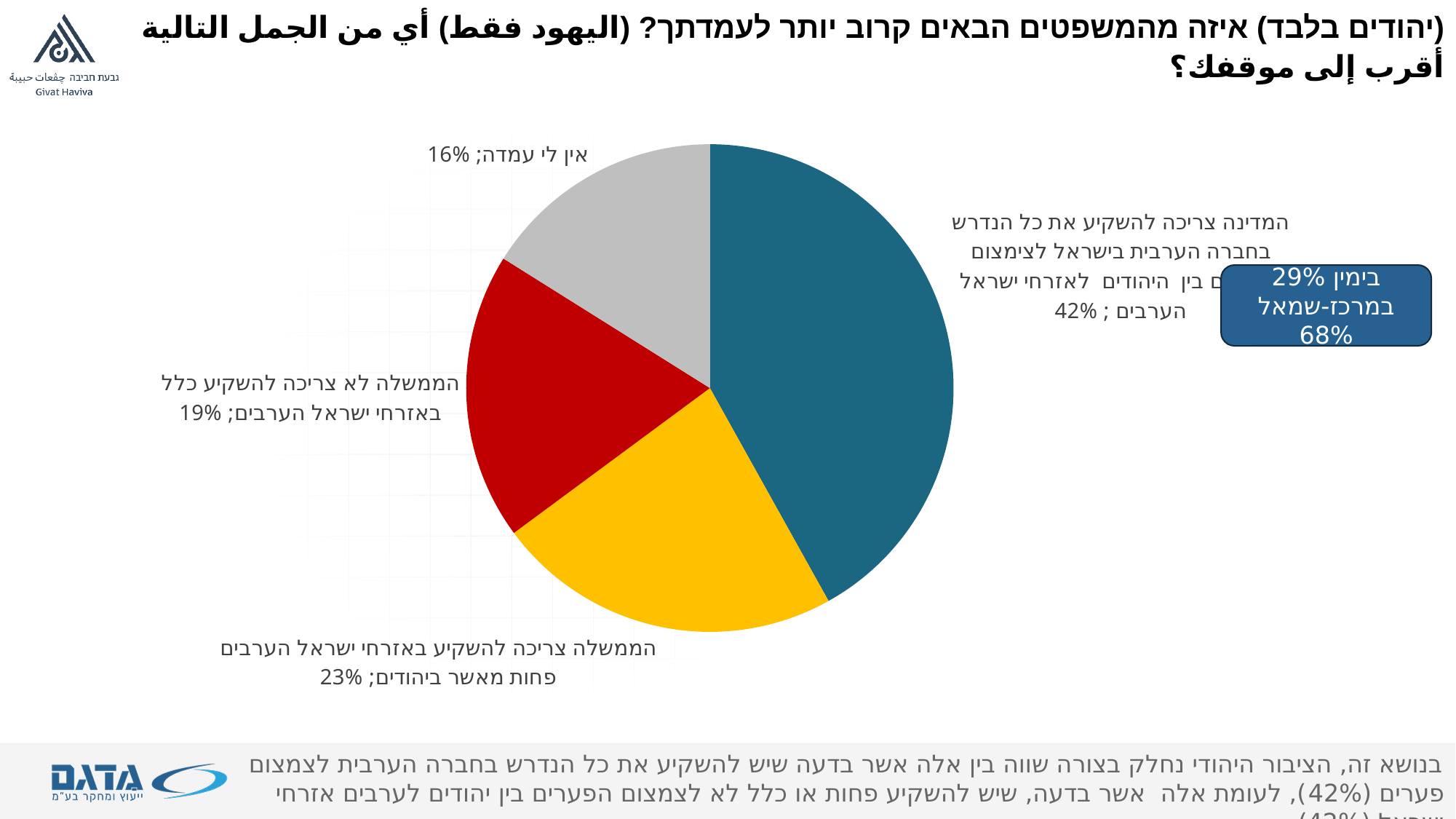
What colour is the slice labelled "אין לי עמדה"? grey What is the difference in percentage points between the largest slice (42%) and the slice "הממשלה צריכה להשקיע באזרחי ישראל הערבים פחות מאשר ביהודים" (23%)? 19 percentage points Which slice of the pie chart is the largest? המדינה צריכה להשקיע את כל הנדרש בחברה הערבית בישראל לצימצום הפערים (42%) What percentage is shown for the slice "המדינה צריכה להשקיע את כל הנדרש בחברה הערבית בישראל לצימצום הפערים"? 42% What kind of chart is shown on the slide? pie chart What percentage is shown for the slice "הממשלה לא צריכה להשקיע כלל באזרחי ישראל הערבים"? 19% What percentage is shown for the slice "הממשלה צריכה להשקיע באזרחי ישראל הערבים פחות מאשר ביהודים"? 23% Which is larger: the slice "הממשלה לא צריכה להשקיע כלל באזרחי ישראל הערבים" or the slice "אין לי עמדה"? הממשלה לא צריכה להשקיע כלל באזרחי ישראל הערבים (19%) Which slice of the pie chart is the smallest? אין לי עמדה (16%) What percentage is shown for the slice "אין לי עמדה" (no opinion)? 16% How many slices does the pie chart have? 4 What colour is the largest slice of the pie chart? blue (teal)